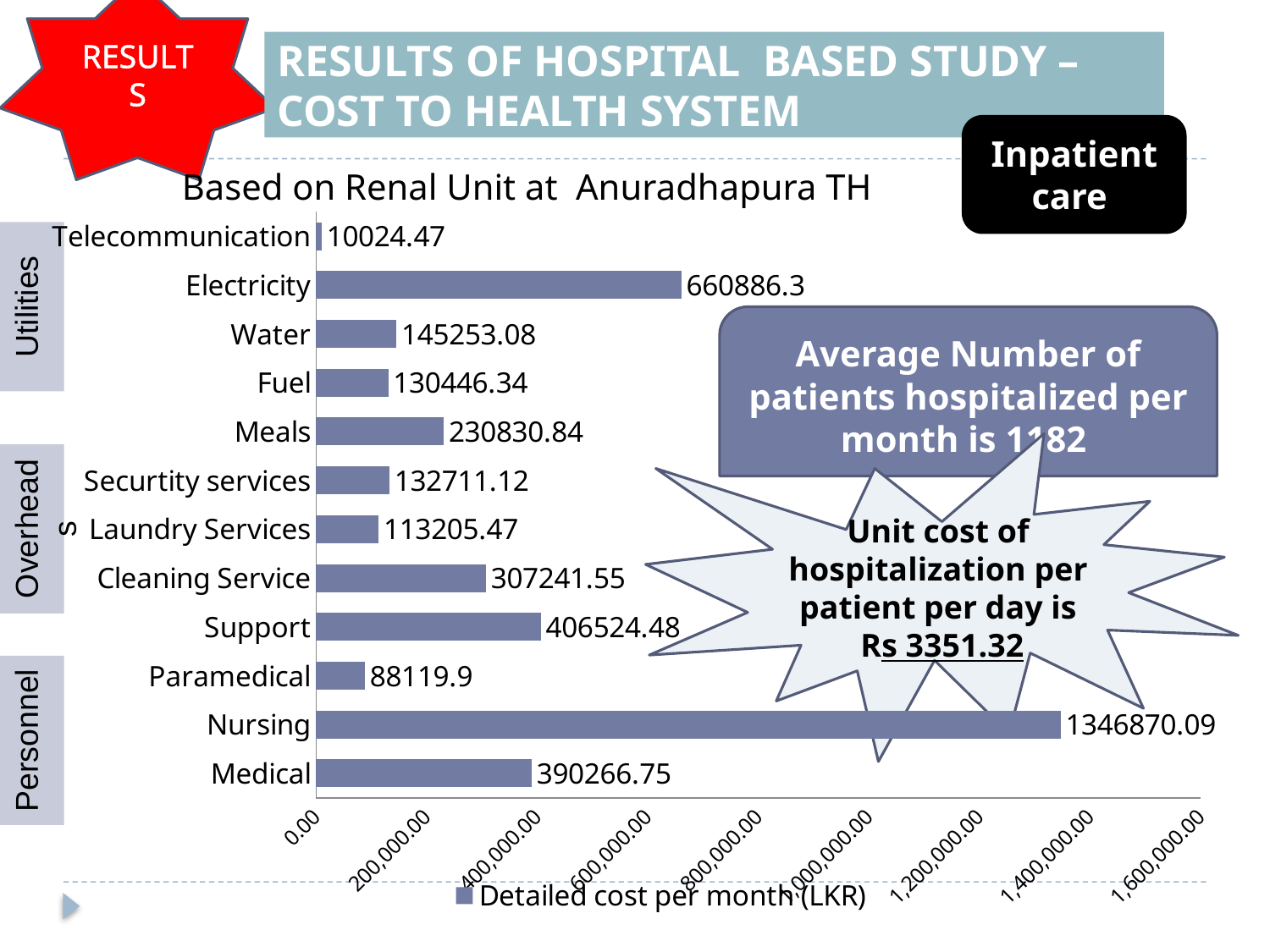
What is the detailed cost per month for Laundry Services? 113205.47 What is the difference between the Support cost and the Medical cost? 16257.73 Which category has the lowest detailed cost per month? Telecommunication Which has a higher detailed cost per month, Cleaning Service or Meals? Cleaning Service What is the difference between the Electricity cost and the Water cost? 515633.22 Is the value for Nursing greater or less than 1,200,000.00? greater How many series does the legend list? 1 Which category has the highest detailed cost per month? Nursing What is the detailed cost per month for Electricity? 660886.3 What kind of chart is shown on the slide? Bar chart How many categories are shown in the chart? 12 What is the detailed cost per month for Nursing? 1346870.09